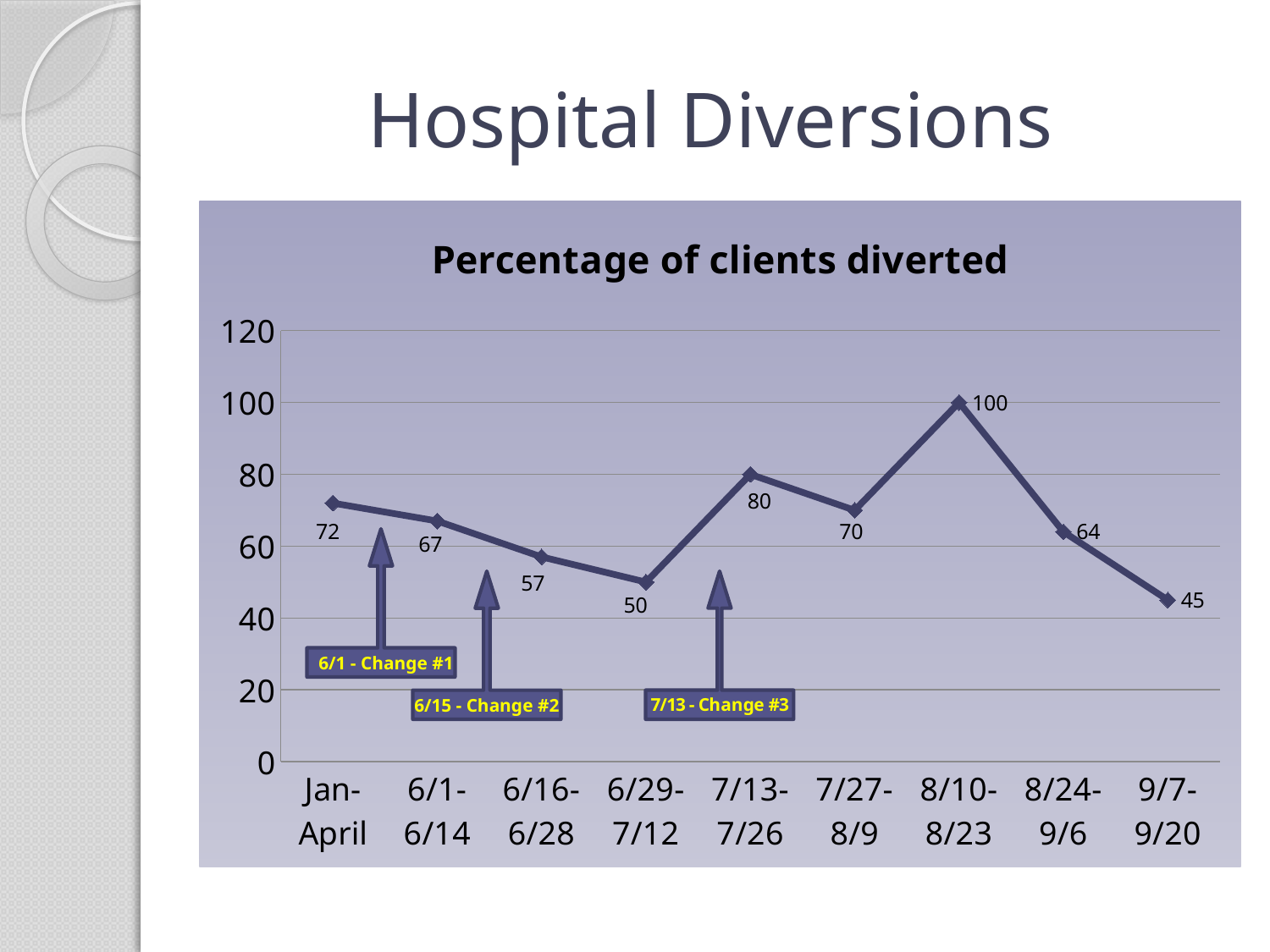
Do the values rise or fall from Jan-April to 6/29-7/12? fall What is the title of the chart? Percentage of clients diverted Which is larger, the value for 7/13-7/26 or the value for 7/27-8/9? 7/13-7/26 What is the difference between the values for 8/10-8/23 and 8/24-9/6? 36 What is the value for 8/10-8/23? 100 What kind of chart is shown? line chart What is the value for Jan-April? 72 Is the value for 6/29-7/12 greater or less than 60? less How many periods are plotted on the x axis? 9 Which period has the lowest percentage of clients diverted? 9/7-9/20 What is the value for 9/7-9/20? 45 Which period has the highest percentage of clients diverted? 8/10-8/23